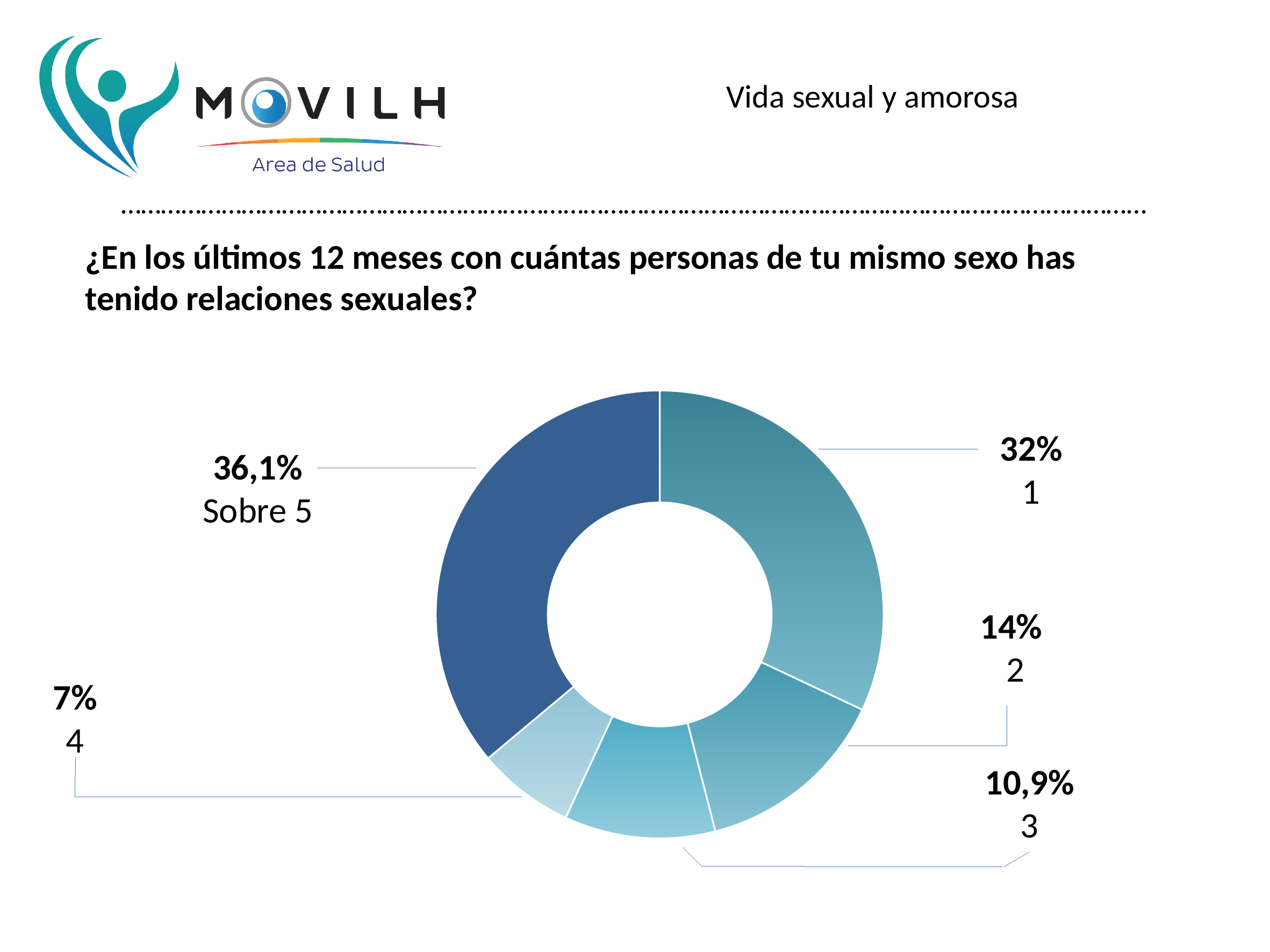
What is the difference between the share for "Sobre 5" and the share for 1? 4,1% What is the value shown for the category 4? 7% What question does the chart answer, according to the slide title? ¿En los últimos 12 meses con cuántas personas de tu mismo sexo has tenido relaciones sexuales? Which category has the largest share of the chart? Sobre 5 What percentage corresponds to the category "Sobre 5"? 36,1% What percentage of respondents reported having had sexual relations with 1 person of the same sex in the last 12 months? 32% What kind of chart is shown on the slide? Pie chart (donut) How many categories are shown in the chart? 5 What is the value shown for the category 3? 10,9% What is the difference between the share for 2 and the share for 4? 7% Which category has the smallest share of the chart? 4 Which is larger, the share for 2 or the share for 3? 2